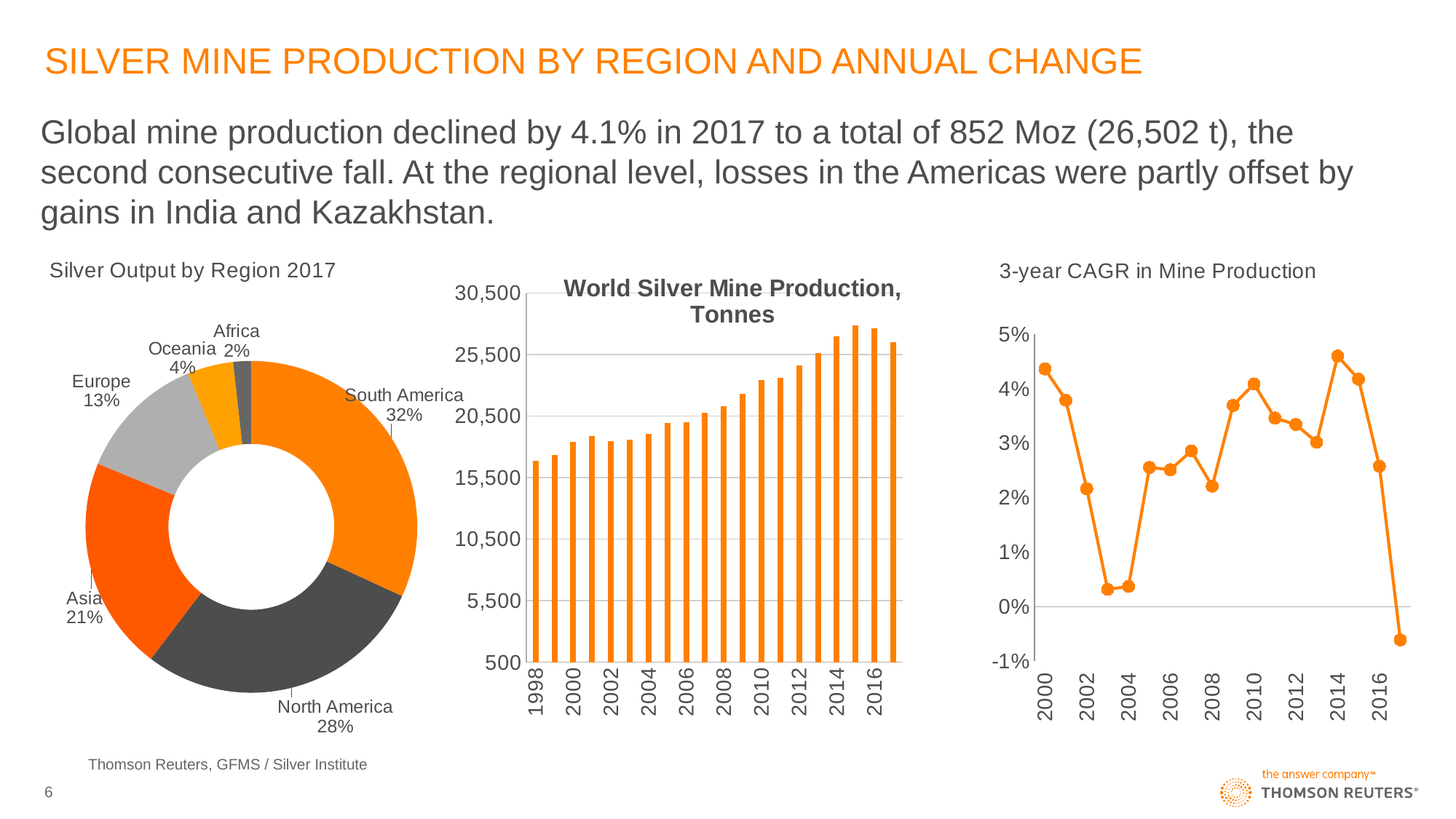
What kind of chart is the World Silver Mine Production, Tonnes chart? Bar chart How many regions are shown in the Silver Output by Region 2017 chart? 6 In the Silver Output by Region 2017 chart, which region has the largest share? South America In the Silver Output by Region 2017 chart, what share of output does South America account for? 32% In the Silver Output by Region 2017 chart, what is the difference between the shares of North America and Asia? 7% In the 3-year CAGR in Mine Production chart, which year has the lowest value? 2017 In the 3-year CAGR in Mine Production chart, is the value for 2003 greater or less than 1%? less In the Silver Output by Region 2017 chart, what is the share for Europe? 13% In the World Silver Mine Production, Tonnes chart, which year has the highest bar? 2015 In the World Silver Mine Production, Tonnes chart, is the value for 1998 greater or less than 20,500? less In the Silver Output by Region 2017 chart, which region has the smallest share? Africa In the World Silver Mine Production, Tonnes chart, do values generally rise or fall from 1998 to 2015? Rise